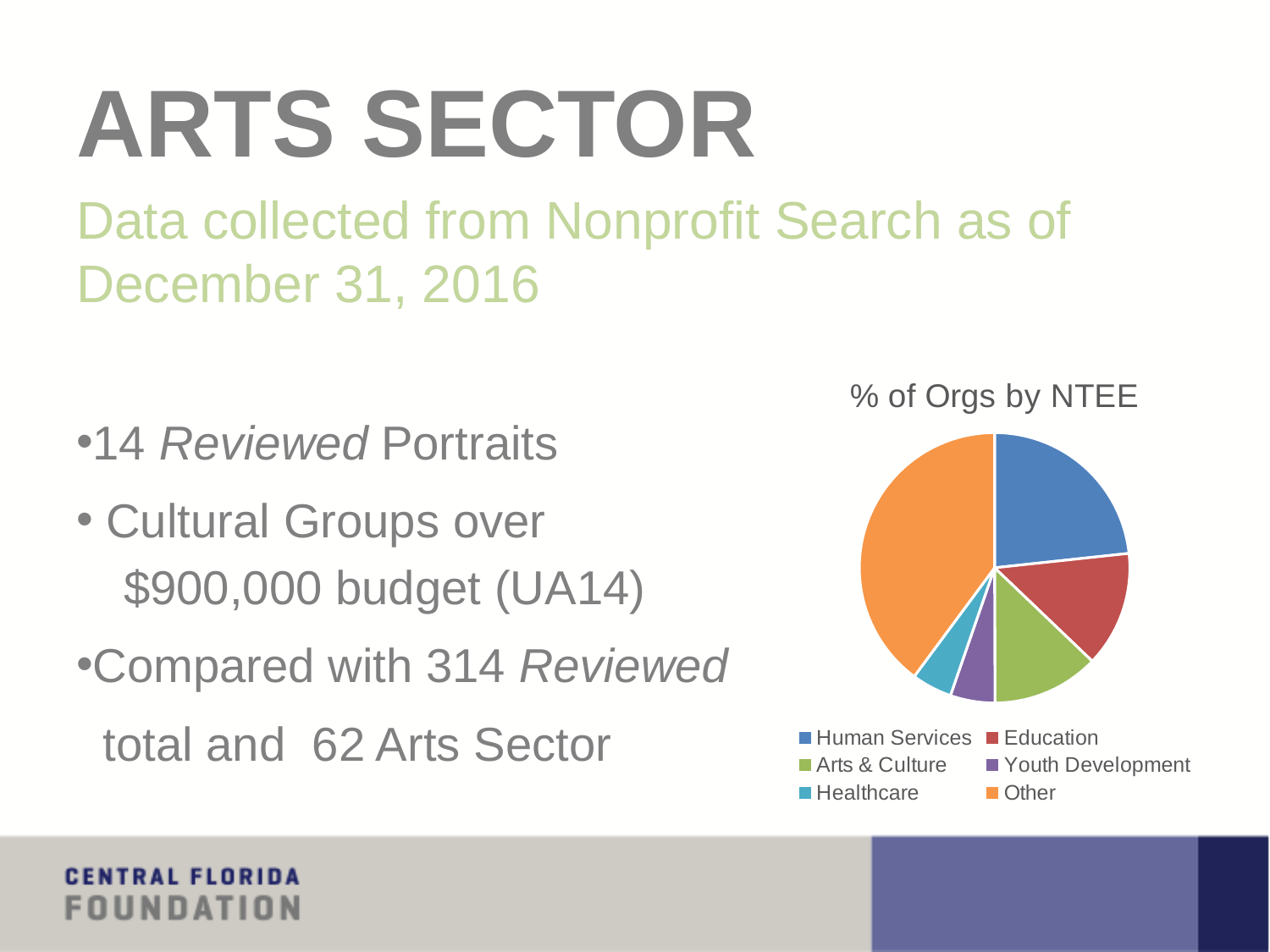
What is the title of the chart on the slide? % of Orgs by NTEE What kind of chart is shown on the slide? pie chart Which category has the largest slice of the pie chart? Other How many categories does the pie chart show? 6 Which slice is larger, Education or Healthcare? Education Which slice is larger, Human Services or Arts & Culture? Human Services Which slice is larger, Human Services or Education? Human Services What colour is the Other slice in the pie chart? orange How many entries does the chart's legend list? 6